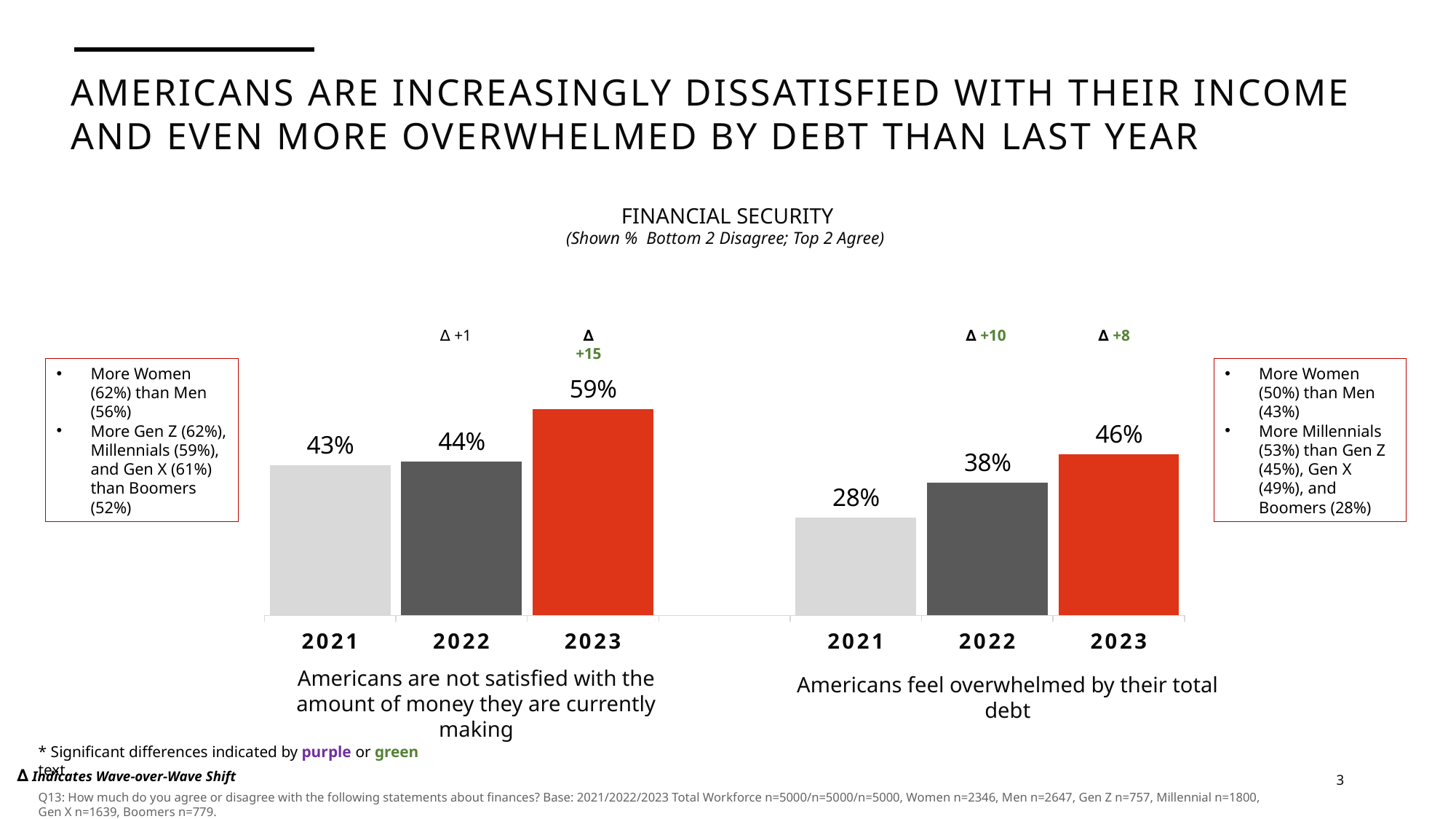
In the chart 'Americans feel overwhelmed by their total debt', what is the difference between the 2023 and 2021 values? 18 percentage points What is the title shown above the charts on this slide? FINANCIAL SECURITY How many years are shown in the chart 'Americans feel overwhelmed by their total debt'? 3 What type of chart is used on this slide? Bar chart In the chart 'Americans are not satisfied with the amount of money they are currently making', which year has the lowest value? 2021 In the chart 'Americans feel overwhelmed by their total debt', which year has the highest value? 2023 In the chart 'Americans are not satisfied with the amount of money they are currently making', what is the value for 2023? 59% In the chart 'Americans feel overwhelmed by their total debt', do the values rise or fall from 2021 to 2023? Rise In the chart 'Americans feel overwhelmed by their total debt', what is the value for 2022? 38% In the chart 'Americans feel overwhelmed by their total debt', what is the value for 2021? 28% In the chart 'Americans are not satisfied with the amount of money they are currently making', what is the difference between the 2023 and 2022 values? 15 percentage points Which is larger: the 2023 value in the 'not satisfied with the amount of money' chart or the 2023 value in the 'overwhelmed by their total debt' chart? The 'not satisfied with the amount of money' chart (59%)